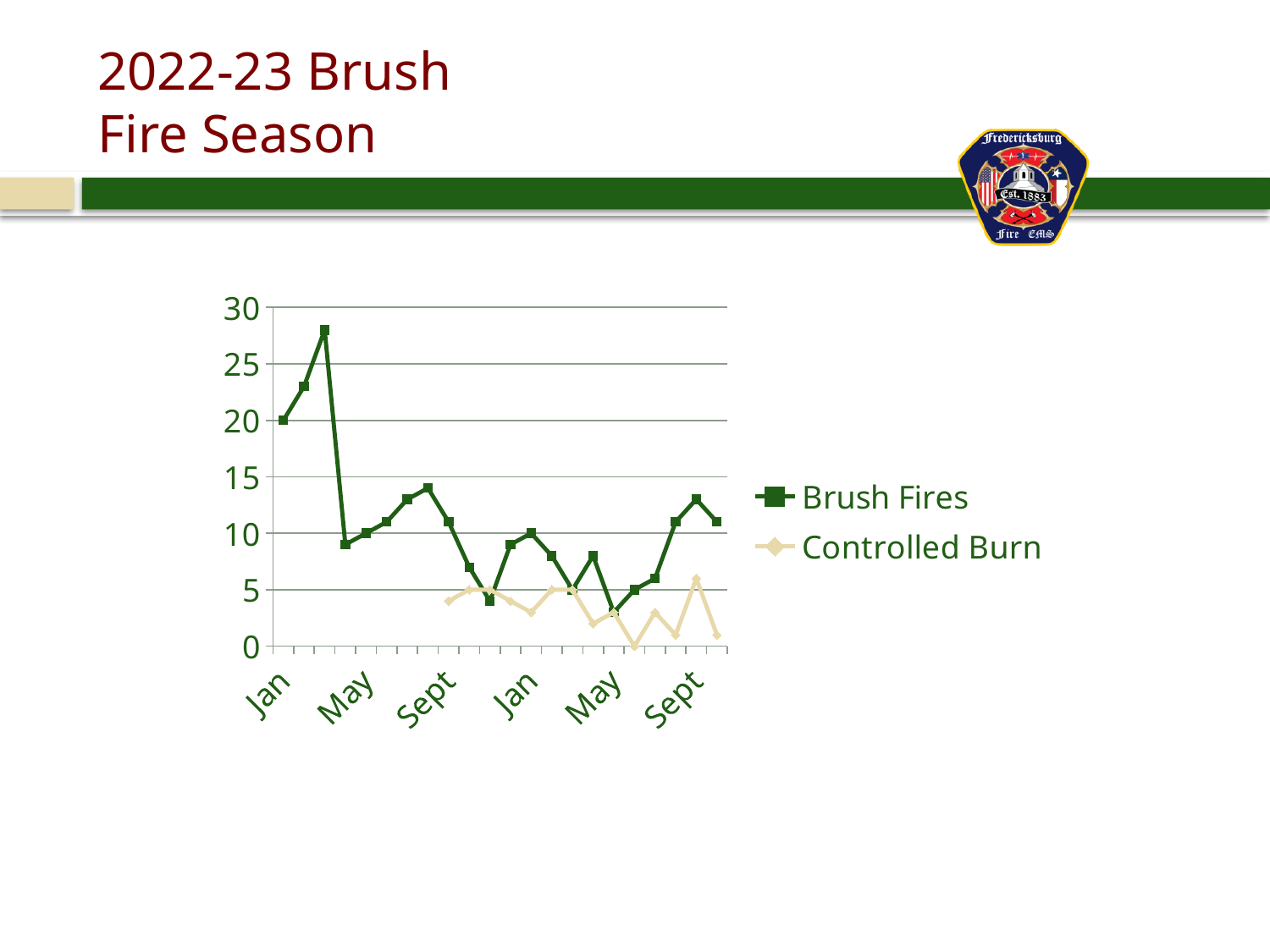
Is the Brush Fires value at the first Jan greater or less than 15? greater Is the Controlled Burn value at the second May greater or less than 5? less At the second Sept, which series has the larger value, Brush Fires or Controlled Burn? Brush Fires Is the highest Brush Fires value greater or less than 25? greater What are the two series named in the legend? Brush Fires and Controlled Burn What colour is the Brush Fires line? green Do the Brush Fires values rise or fall between the first Jan and the first May? fall What is the Brush Fires value at the first Jan on the x axis? 20 How many month labels are shown on the x axis? 6 What kind of chart is shown on the slide? line chart How many series does the legend list? 2